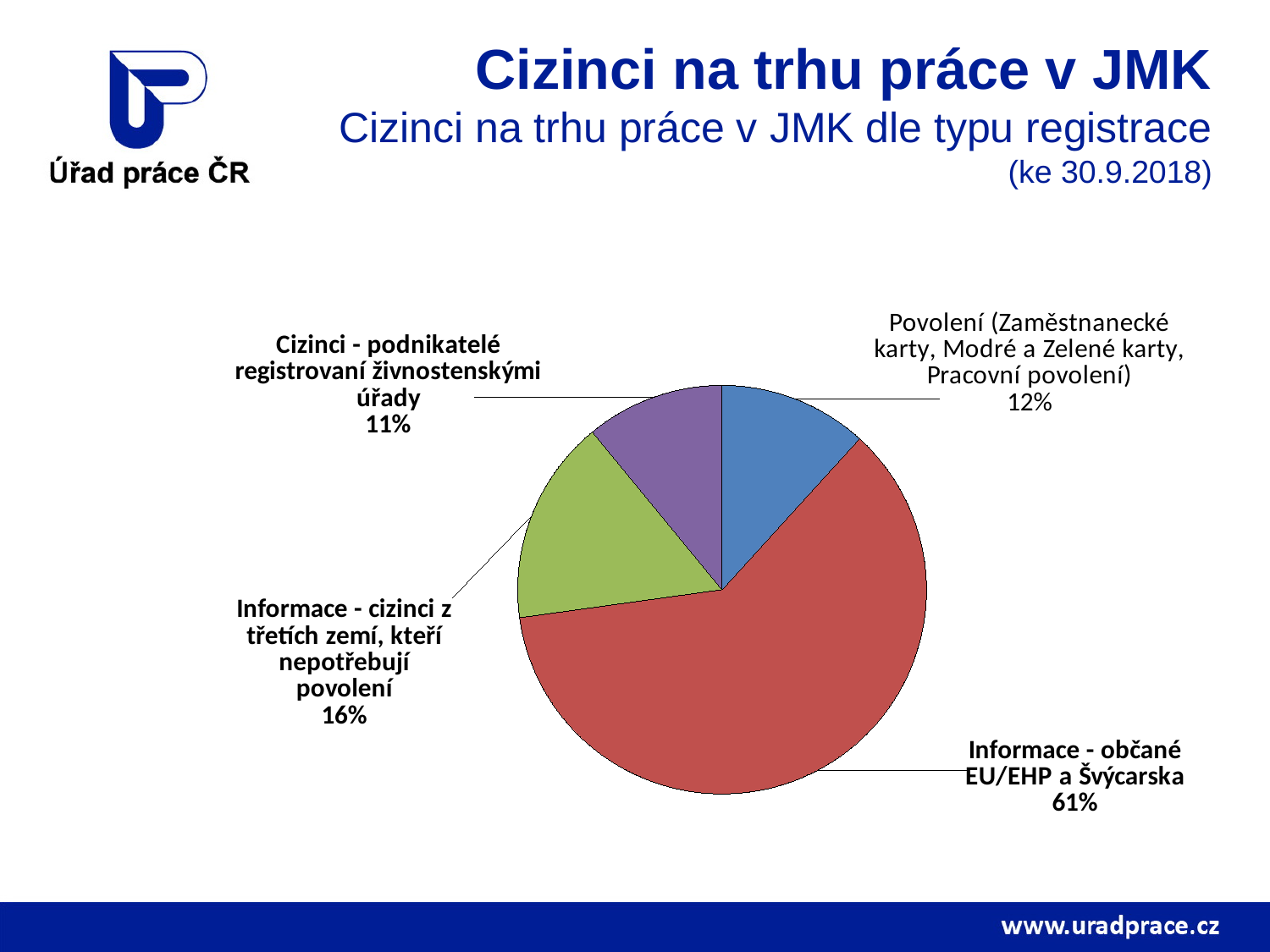
What share of the pie does "Informace - občané EU/EHP a Švýcarska" represent? 61% Which is larger: the share for "Povolení (Zaměstnanecké karty, Modré a Zelené karty, Pracovní povolení)" or the share for "Informace - cizinci z třetích zemí, kteří nepotřebují povolení"? Informace - cizinci z třetích zemí, kteří nepotřebují povolení What kind of chart is shown on the slide? Pie chart Which category has the smallest slice of the pie? Cizinci - podnikatelé registrovaní živnostenskými úřady What share of the pie does "Cizinci - podnikatelé registrovaní živnostenskými úřady" represent? 11% What share of the pie does "Informace - cizinci z třetích zemí, kteří nepotřebují povolení" represent? 16% What colour is the slice for "Informace - občané EU/EHP a Švýcarska"? Red How many slices does the pie chart have? 4 Which category has the largest slice of the pie? Informace - občané EU/EHP a Švýcarska What date is the chart data stated to be valid as of? 30.9.2018 What is the difference in percentage points between the share for "Informace - občané EU/EHP a Švýcarska" and the share for "Informace - cizinci z třetích zemí, kteří nepotřebují povolení"? 45